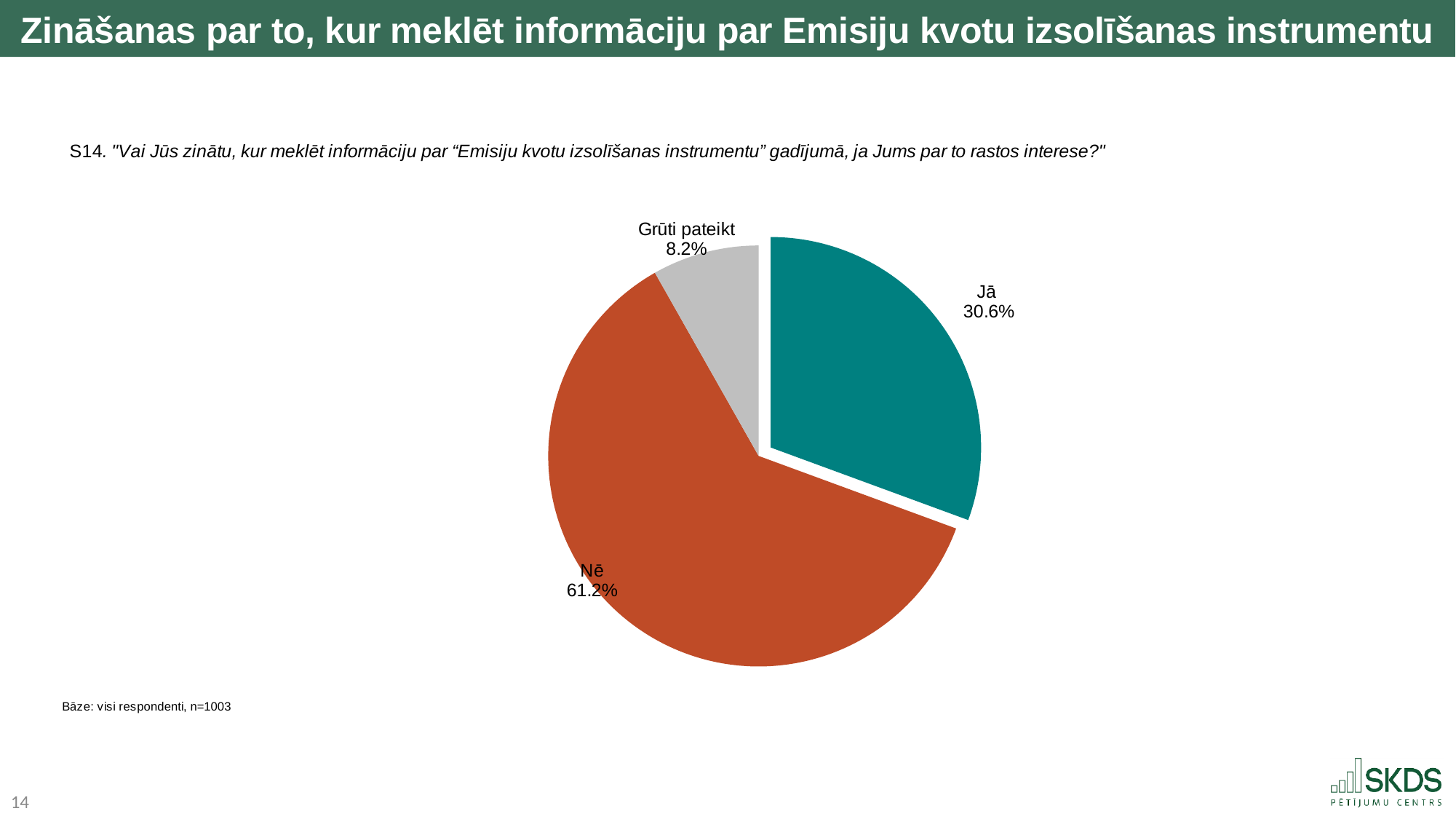
What share of respondents answered "Grūti pateikt"? 8.2% What is the base (n) stated for the chart? n=1003 Which answer has the largest share of the pie? Nē What is the difference in percentage points between the "Nē" and "Jā" shares? 30.6 What share of respondents answered "Nē"? 61.2% What colour is the "Nē" slice? Orange-red What share of respondents answered "Jā"? 30.6% What is the combined share of "Jā" and "Grūti pateikt"? 38.8% What kind of chart is shown on the slide? Pie chart Which is larger, the share for "Jā" or the share for "Grūti pateikt"? Jā Which answer has the smallest share of the pie? Grūti pateikt How many slices does the pie chart have? 3